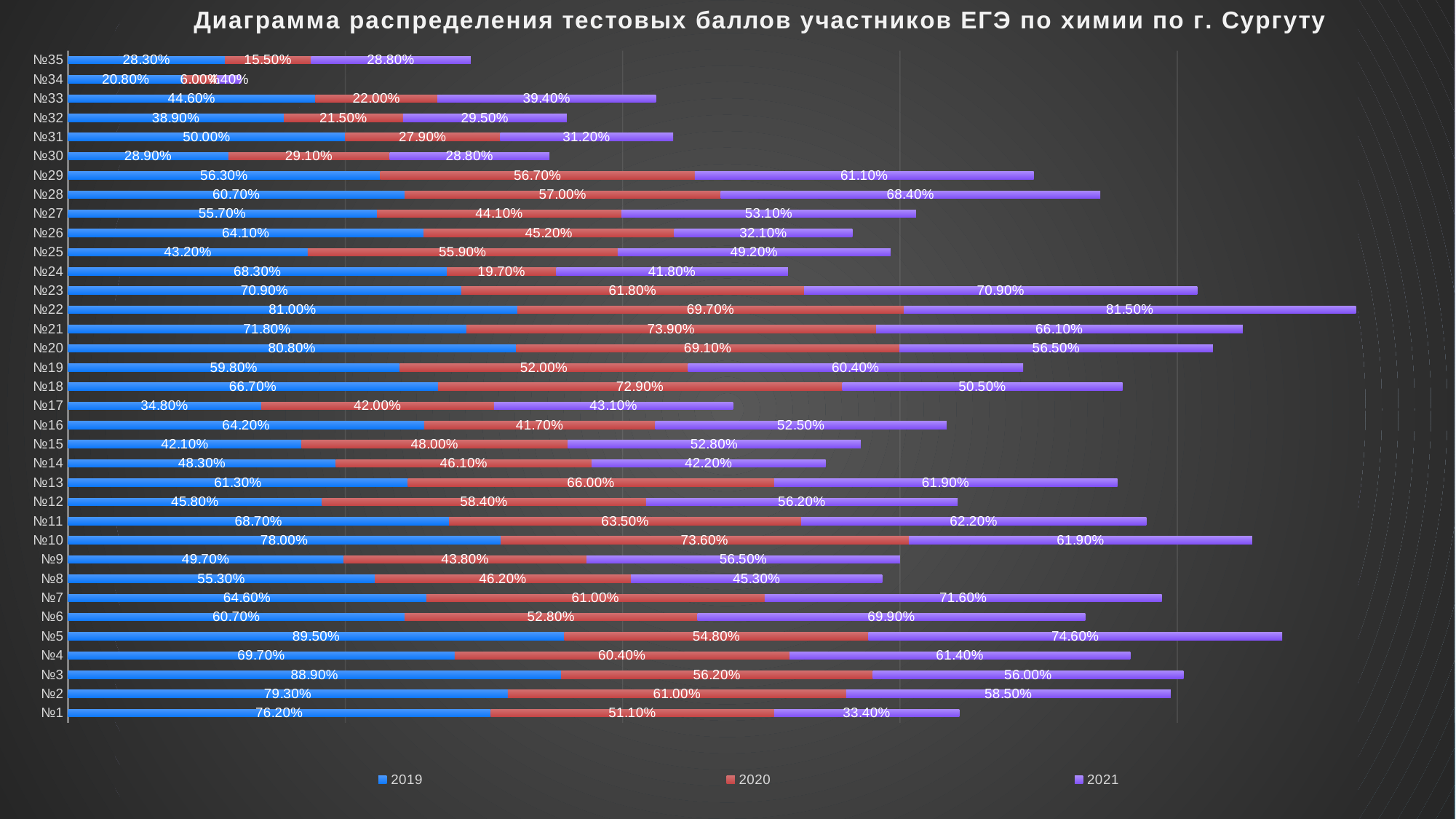
What is the difference between the 2019 and 2020 values for №22? 11.30% What is the 2020 value for №18? 72.90% Which has the larger 2019 value, №10 or №11? №10 Which colour represents the 2021 series in the legend? Purple What kind of chart is shown on the slide? Stacked bar chart How many series does the legend list? 3 Which category has the lowest 2019 value? №34 What is the 2021 value for №22? 81.50% What is the total of the stacked bar for №1? 160.70% How many categories are shown on the chart? 35 Which category has the highest 2021 value? №22 What is the 2019 value for №5? 89.50%